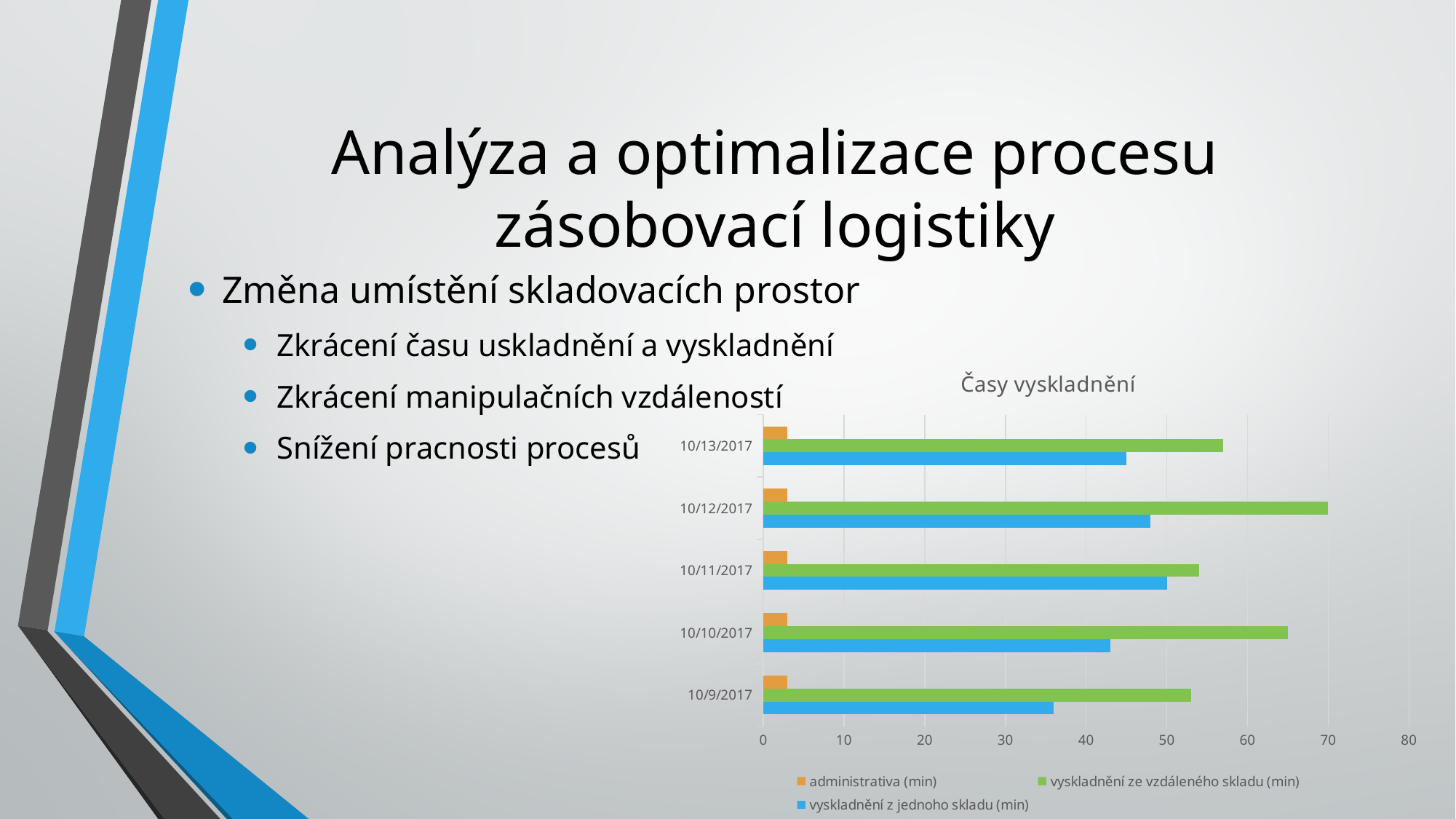
Is the value for 'vyskladnění z jednoho skladu (min)' on 10/12/2017 greater or less than 50? less Is the value for 'vyskladnění ze vzdáleného skladu (min)' on 10/10/2017 greater or less than 60? greater What is the title of the chart? Časy vyskladnění Is the value for 'vyskladnění z jednoho skladu (min)' on 10/9/2017 greater or less than 40? less Which date has the highest value for 'vyskladnění ze vzdáleného skladu (min)'? 10/12/2017 How many dates are shown on the chart's vertical axis? 5 What type of chart is shown on the slide? bar chart Which date has the lowest value for 'vyskladnění z jednoho skladu (min)'? 10/9/2017 Which colour represents the 'administrativa (min)' series in the chart? orange How many series does the chart legend list? 3 On 10/13/2017, which is larger: 'vyskladnění ze vzdáleného skladu (min)' or 'vyskladnění z jednoho skladu (min)'? vyskladnění ze vzdáleného skladu (min)